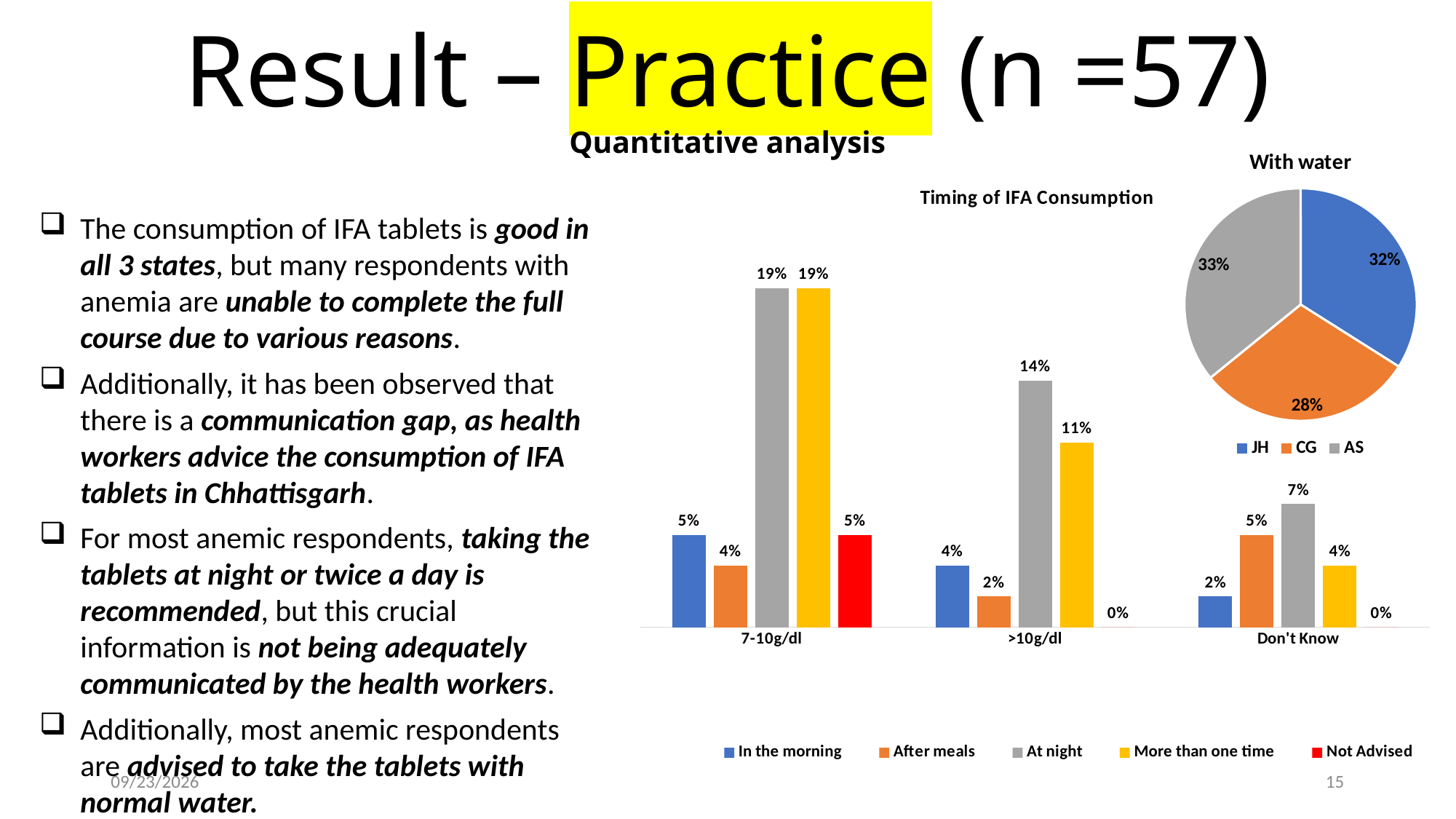
In the 'Timing of IFA Consumption' chart, what is the value for 'At night' in the 7-10g/dl category? 19% In the 'Timing of IFA Consumption' chart, which is larger in the Don't Know category: 'In the morning' or 'After meals'? After meals How many series does the legend of the 'Timing of IFA Consumption' chart list? 5 In the 'With water' pie chart, which state has the smallest share? CG What kind of chart is the 'Timing of IFA Consumption' chart? Bar chart What kind of chart is the 'With water' chart? Pie chart In the 'Timing of IFA Consumption' chart, which series has the highest value in the >10g/dl category? At night In the 'Timing of IFA Consumption' chart, what is the value for 'More than one time' in the Don't Know category? 4% How many categories are shown on the x axis of the 'Timing of IFA Consumption' chart? 3 In the 'Timing of IFA Consumption' chart, what is the difference between 'At night' and 'More than one time' in the >10g/dl category? 3% In the 'Timing of IFA Consumption' chart, what is the value for 'After meals' in the >10g/dl category? 2% In the 'With water' pie chart, what share does CG have? 28%